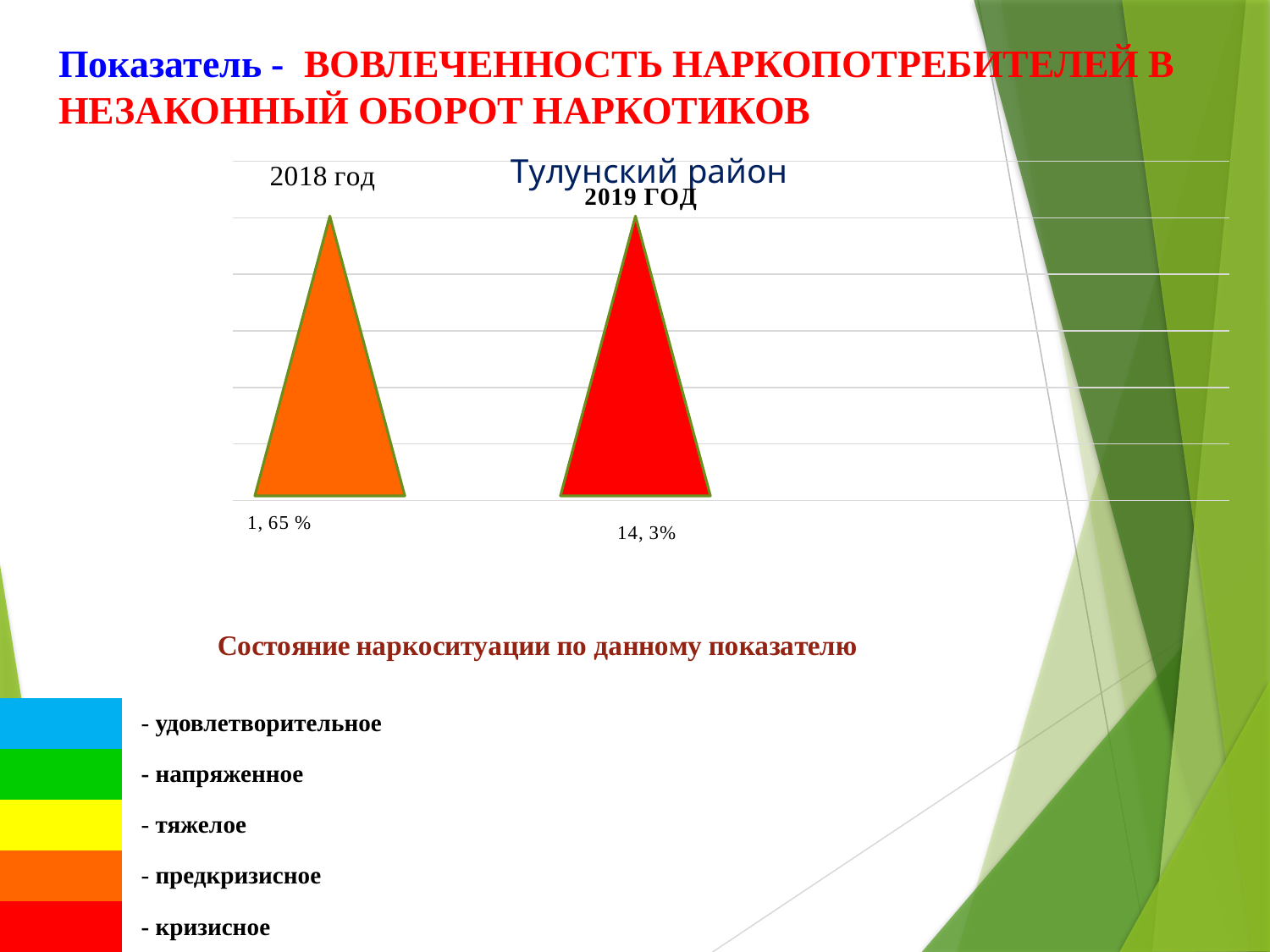
What colour is the bar for 2019 год on the Тулунский район chart? red Which category has the highest value on the Тулунский район chart? 2019 год What value is shown for 2019 год on the Тулунский район chart? 14, 3% What kind of chart is shown on the slide? bar chart Does the value rise or fall from 2018 год to 2019 год on the Тулунский район chart? rise Which year has the higher value on the Тулунский район chart, 2018 год or 2019 год? 2019 год How many categories are plotted on the Тулунский район chart? 2 Which category has the lowest value on the Тулунский район chart? 2018 год What is the title of the chart on the slide? Тулунский район What value is shown for 2018 год on the Тулунский район chart? 1, 65 %